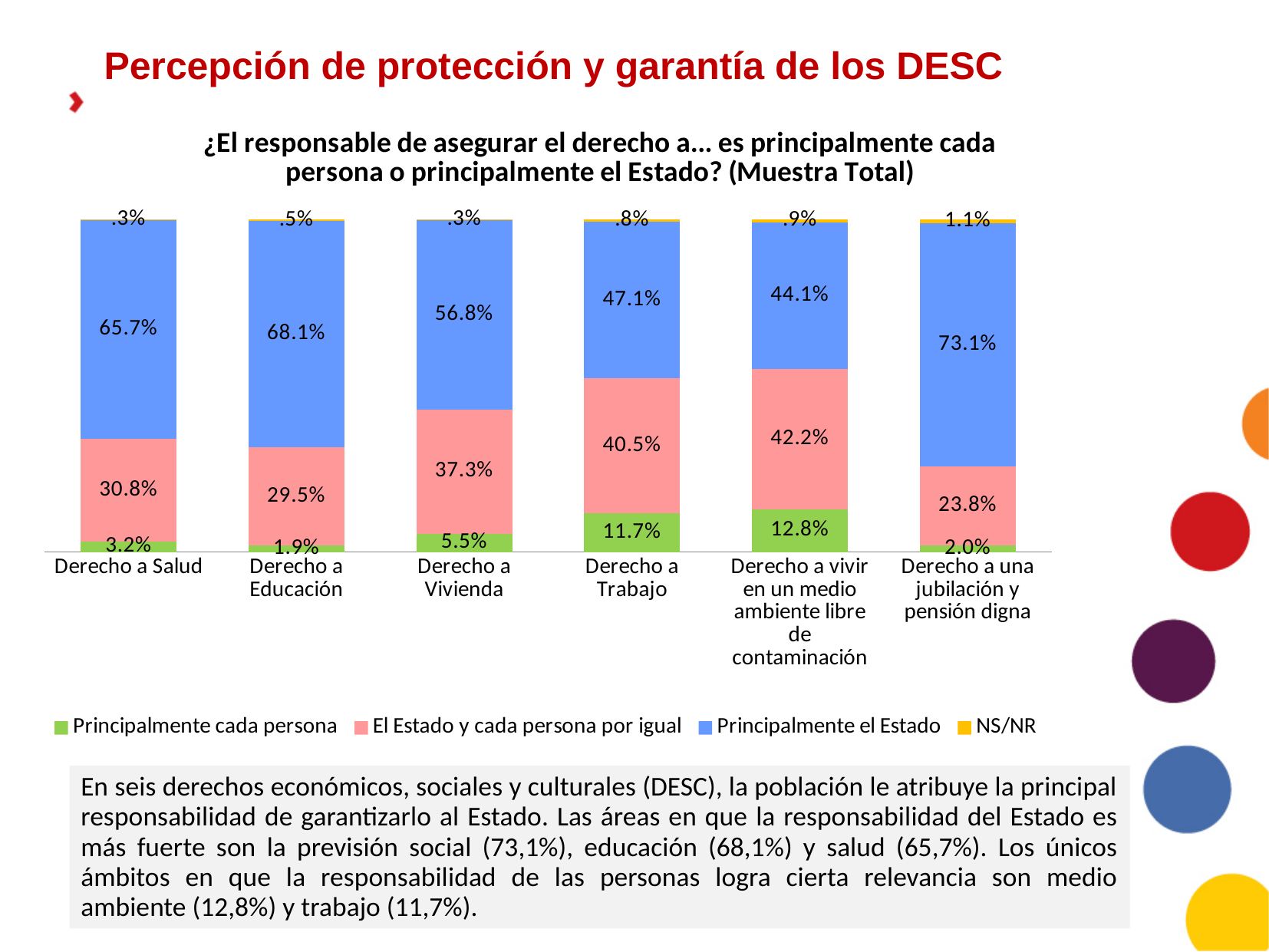
What is the value of 'Principalmente cada persona' for Derecho a Trabajo? 11.7% What is the NS/NR value for Derecho a una jubilación y pensión digna? 1.1% What is the total of the stacked bar for Derecho a Salud? 100.0% How many series does the legend list? 4 Which right has the lowest value for 'Principalmente cada persona'? Derecho a Educación How many rights (categories) are shown on the x axis of the chart? 6 What kind of chart is shown on the slide? Stacked bar chart What is the value of 'El Estado y cada persona por igual' for Derecho a Vivienda? 37.3% Which is larger for Derecho a vivir en un medio ambiente libre de contaminación: 'El Estado y cada persona por igual' or 'Principalmente el Estado'? Principalmente el Estado Which right has the highest value for 'Principalmente el Estado'? Derecho a una jubilación y pensión digna What percentage of respondents said the State is principally responsible for Derecho a Salud? 65.7% What is the difference between the 'Principalmente el Estado' values for Derecho a una jubilación y pensión digna and Derecho a Salud? 7.4 percentage points